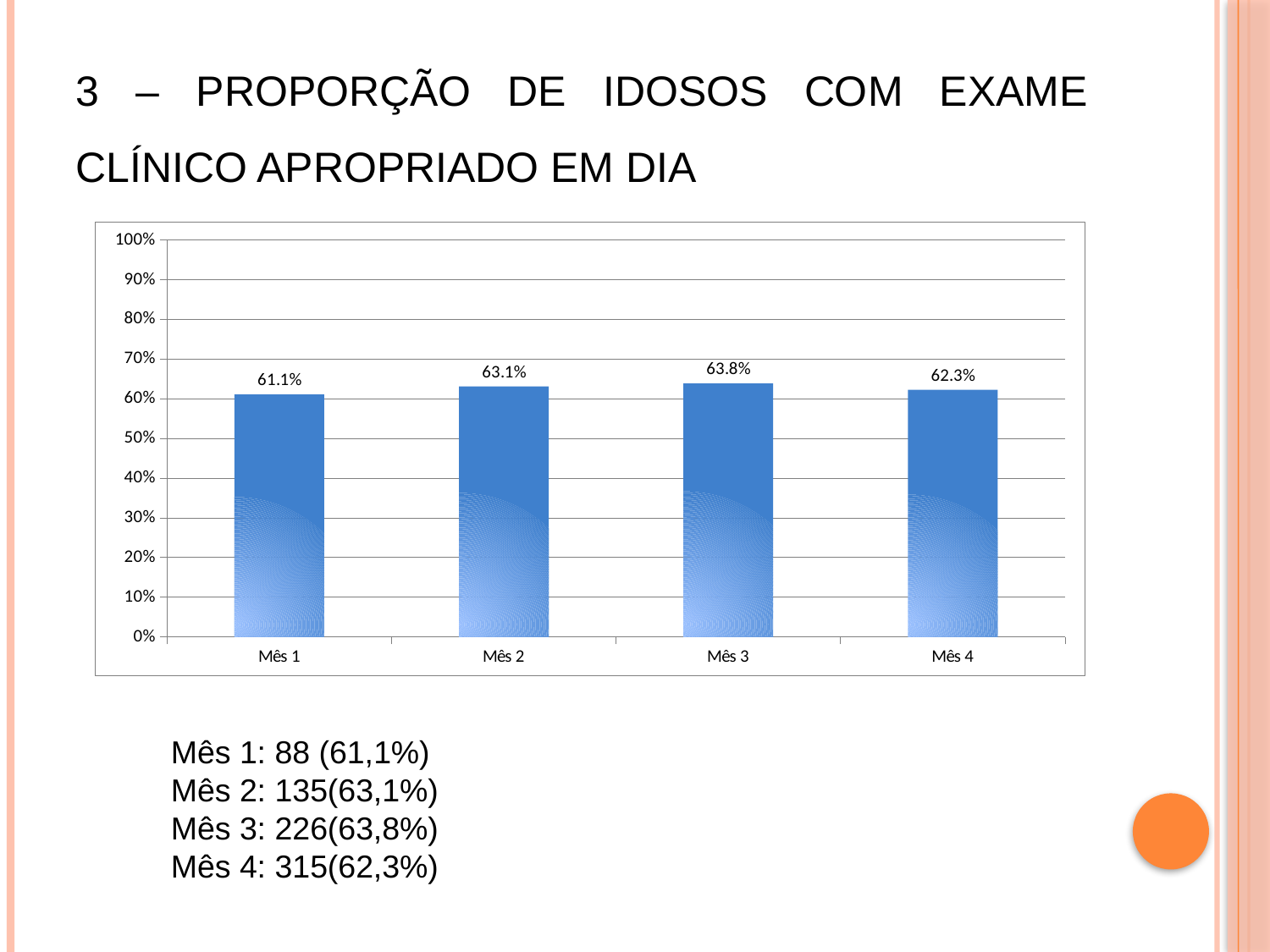
What is the difference between the values for Mês 3 and Mês 1? 2.7% What is the difference between the values for Mês 2 and Mês 4? 0.8% What is the value for Mês 1? 61.1% Which is larger, the value for Mês 2 or the value for Mês 1? Mês 2 Is the value for Mês 3 greater or less than 70%? less What is the value for Mês 3? 63.8% What is the highest value shown on the y axis? 100% What kind of chart is shown on the slide? bar chart What is the value for Mês 4? 62.3% Which month has the lowest value? Mês 1 Which month has the highest value? Mês 3 How many categories are shown on the x axis? 4